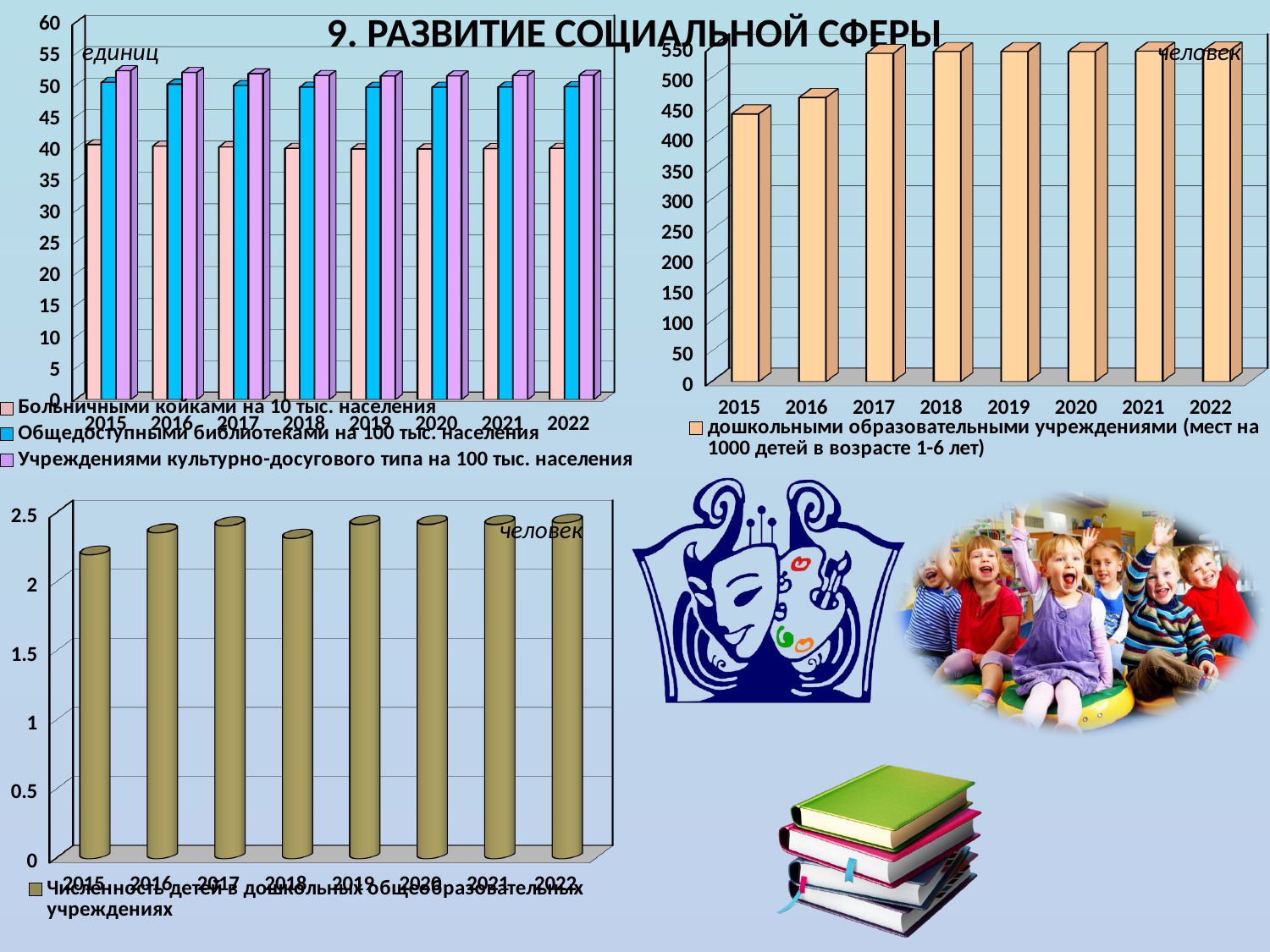
In the top-right chart (человек, дошкольными образовательными учреждениями), is the value for 2015 greater or less than 500? less In the top-right chart (человек, дошкольными образовательными учреждениями), is the value for 2019 greater or less than 500? greater In the top-left chart (единиц), is the value for Больничными койками на 10 тыс. населения in 2015 greater or less than 45? less In the top-left chart (единиц), which is larger in 2018: Больничными койками на 10 тыс. населения or Общедоступными библиотеками на 100 тыс. населения? Общедоступными библиотеками на 100 тыс. населения In the top-left chart (единиц), how many years are shown on the x axis? 8 In the top-left chart (единиц), how many series does the legend list? 3 What type of chart is the bottom-left chart (Численность детей в дошкольных общеобразовательных учреждениях)? bar chart In the top-right chart (человек, дошкольными образовательными учреждениями), which year has the lowest value? 2015 In the bottom-left chart (Численность детей в дошкольных общеобразовательных учреждениях), which year has the lowest value? 2015 In the top-left chart (единиц), which series has the highest values in every year? Учреждениями культурно-досугового типа на 100 тыс. населения